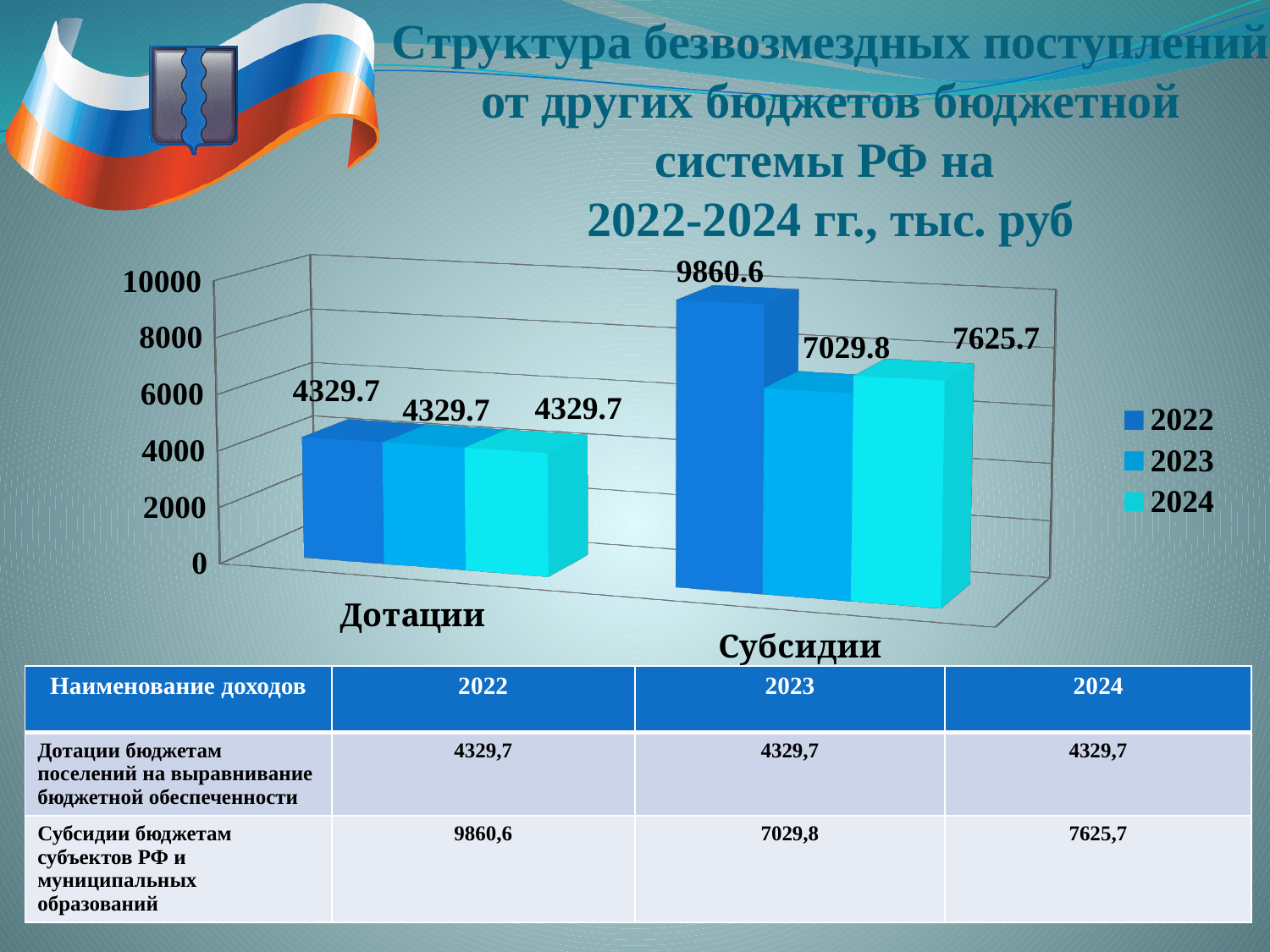
How many series does the legend list? 3 What is the value for Дотации in 2022? 4329.7 What is the value for Субсидии in 2022? 9860.6 Which year has the lowest value for Субсидии? 2023 Which is larger: Субсидии in 2024 or Субсидии in 2023? Субсидии in 2024 What is the value for Субсидии in 2024? 7625.7 Is the value for Дотации in 2023 greater or less than 6000? less What is the difference between the Субсидии values for 2022 and 2023? 2830.8 What is the value for Субсидии in 2023? 7029.8 How many categories are shown on the x axis of the chart? 2 What kind of chart is shown on the slide? bar chart Which year has the highest value for Субсидии? 2022